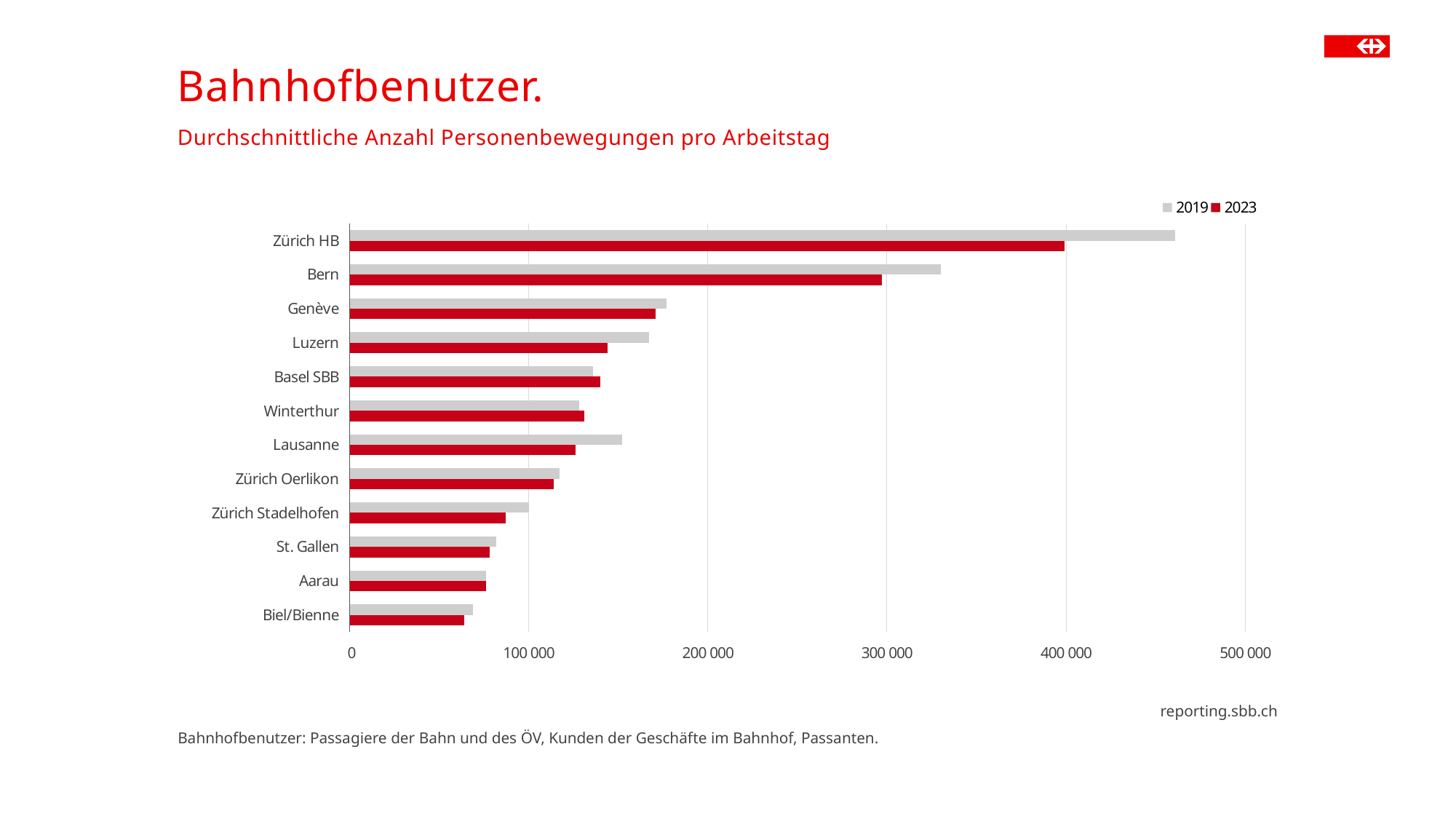
How many series does the legend list? 2 Is the 2019 value for Zürich HB greater or less than 400 000? greater Which station has the highest value for 2019? Zürich HB What kind of chart is shown on the slide? Bar chart Which colour represents the 2023 series in the legend? Red For Lausanne, which year has the larger value, 2019 or 2023? 2019 Which station has the larger 2019 value, Luzern or Lausanne? Luzern Which station has the lowest value for 2023? Biel/Bienne Is the 2023 value for Zürich Stadelhofen greater or less than 100 000? less How many stations are shown on the chart? 12 Is the 2019 value for Bern greater or less than 300 000? greater